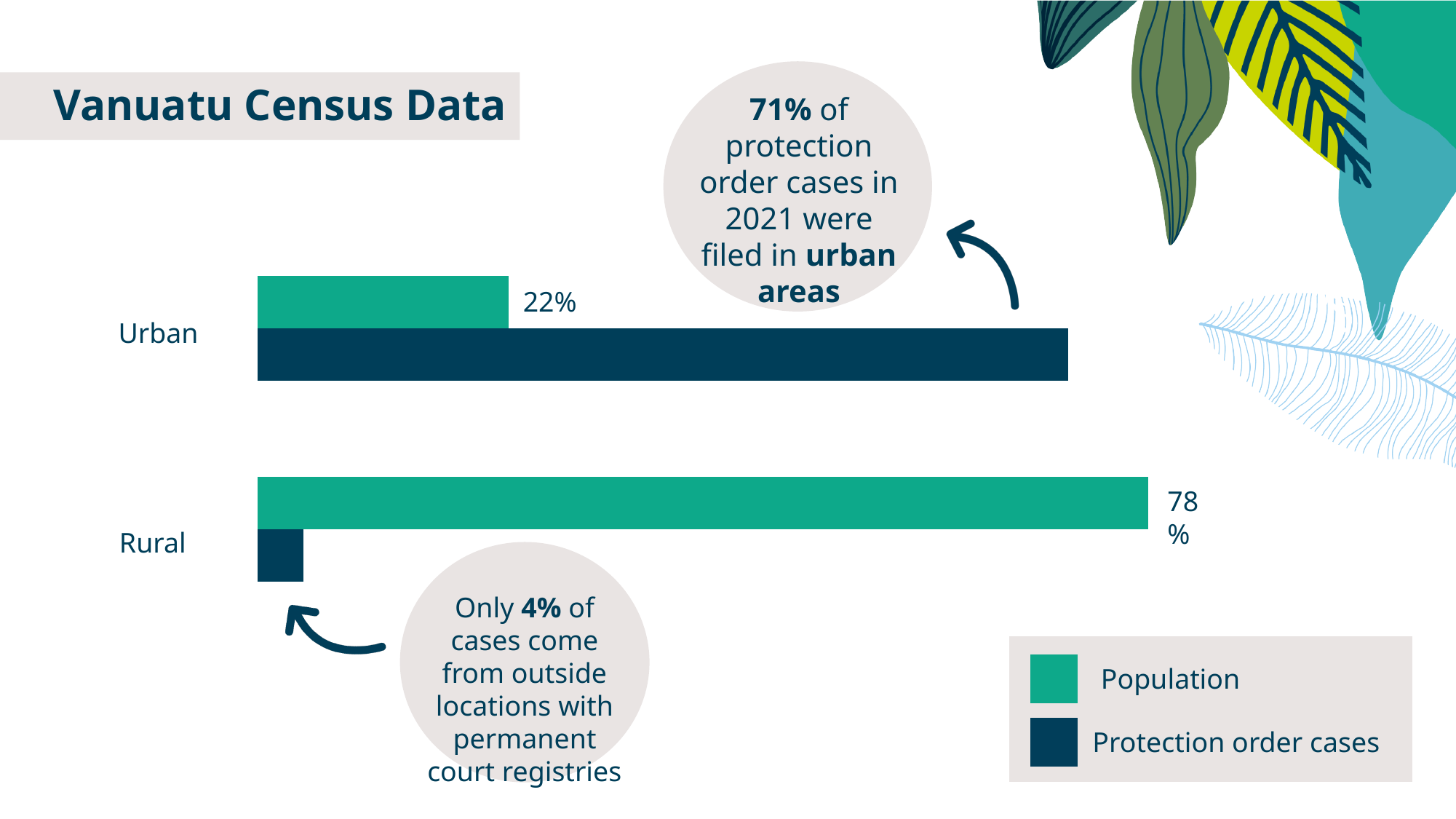
For Urban, which is larger: the Population bar or the Protection order cases bar? Protection order cases What is the title of the slide? Vanuatu Census Data What is the Population value for Urban? 22% How many series does the legend list? 2 Which category has the lower Protection order cases value? Rural What is the Population value for Rural? 78% According to the callout, what share of protection order cases in 2021 were filed in urban areas? 71% How many categories are shown on the chart? 2 Which category has the higher Population value? Rural According to the callout, what share of cases come from outside locations with permanent court registries (Rural)? 4% What is the difference between the Rural and Urban Population values? 56% What kind of chart is shown on the slide? Bar chart